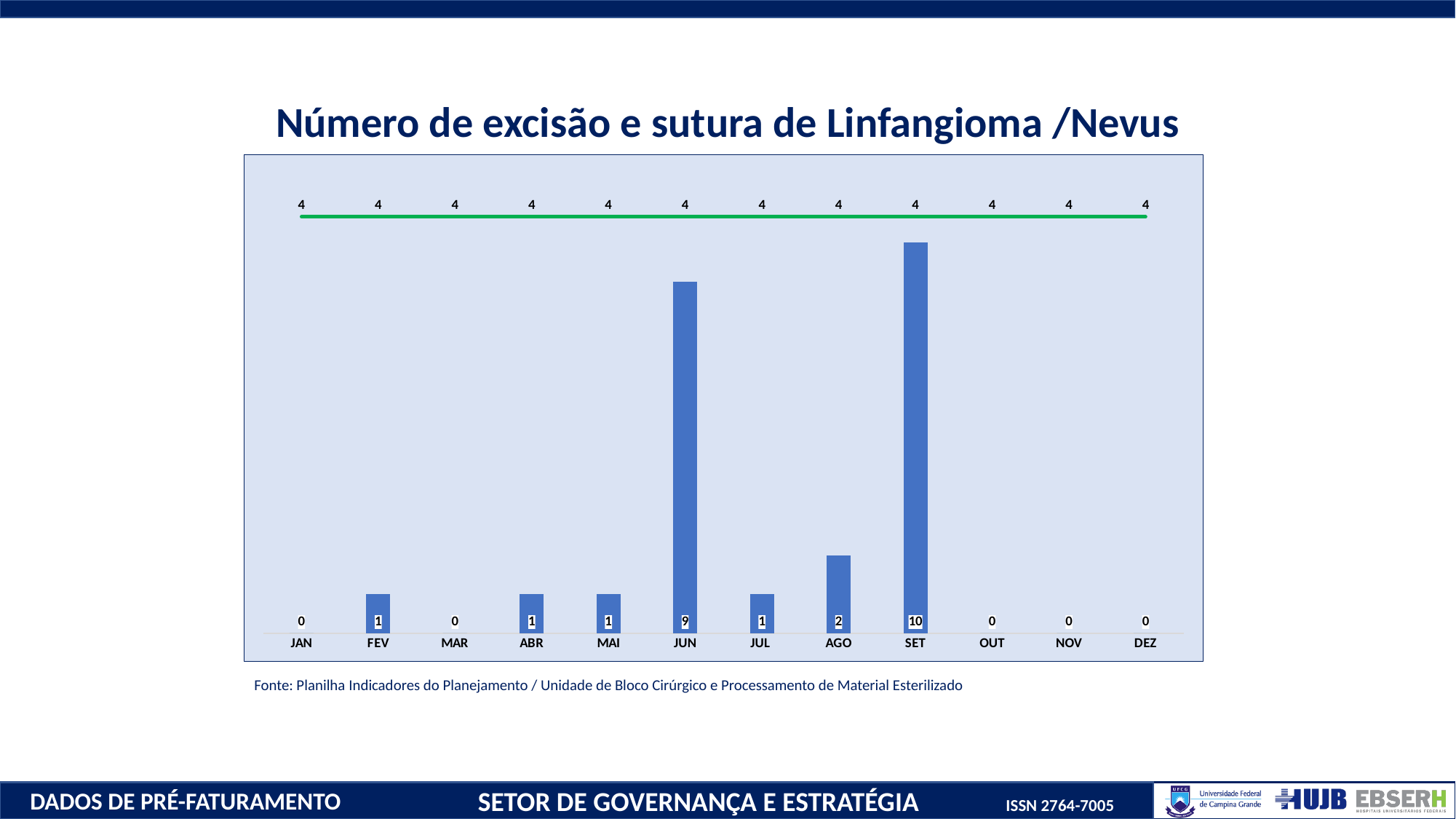
What is the title of the chart? Número de excisão e sutura de Linfangioma /Nevus What is the difference between the bar value for SET and the green line value for SET? 6 What is the value of the bar for JUN? 9 What value does the green line show for each month? 4 How many months have a bar value of 0? 5 What is the value of the bar for AGO? 2 Which month has the highest bar value? SET Which is larger, the bar value for AGO or the bar value for JUL? AGO What is the value of the bar for SET? 10 What is the difference between the bar values for SET and JUN? 1 What kind of chart is shown on the slide? combination bar and line chart How many months are shown on the x axis? 12